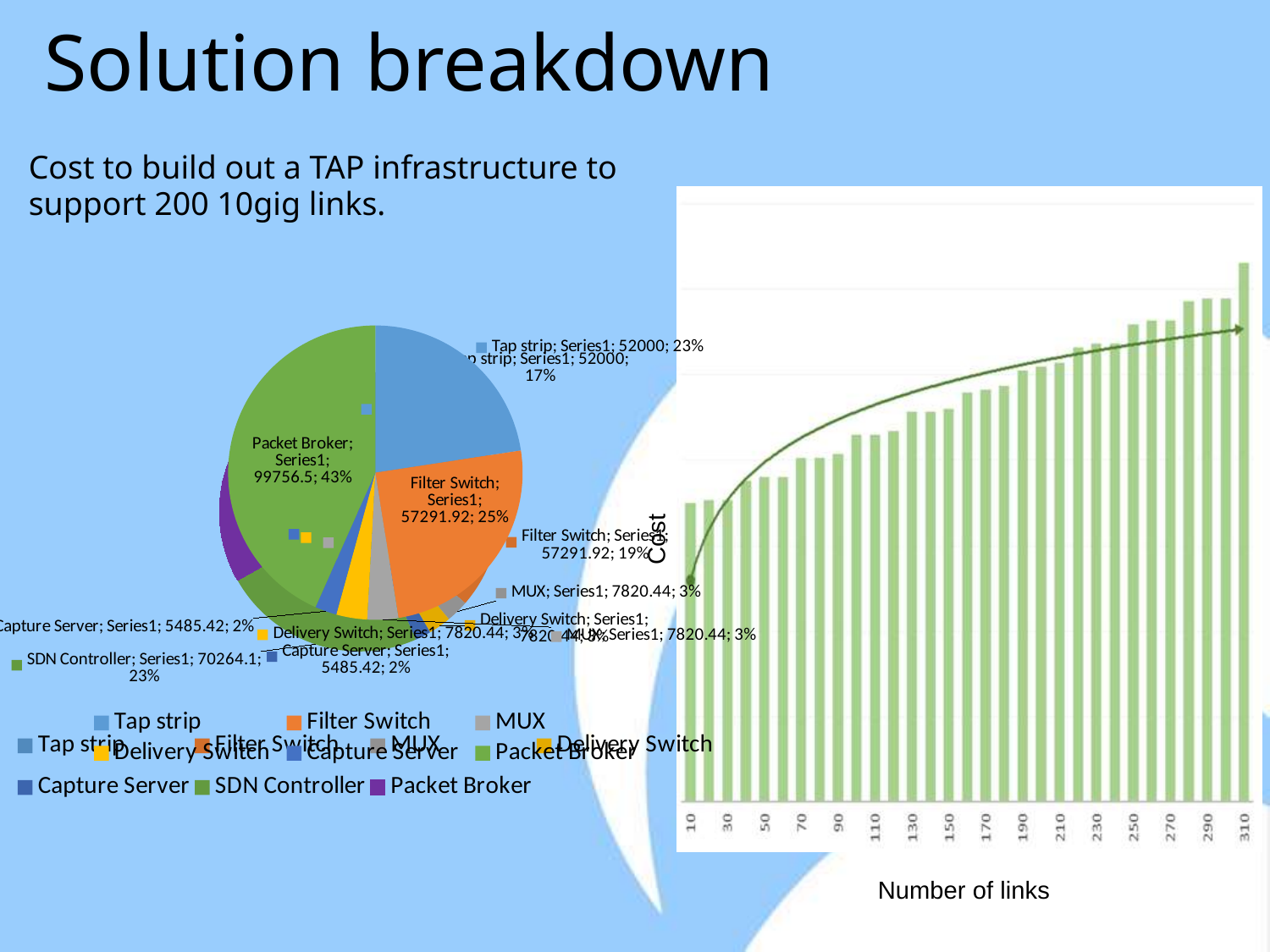
In the pie chart, what is the difference between the Filter Switch value (57291.92) and the Tap strip value (52000)? 5291.92 In the pie chart, what value is shown for Packet Broker? 99756.5 In the pie chart, what value is shown for Capture Server? 5485.42 In the bar chart on the right, do the bars generally rise or fall as the number of links increases? rise In the pie chart, which has the larger value: Packet Broker or Tap strip? Packet Broker In the bar chart on the right, which bar is taller: the one at 310 links or the one at 10 links? 310 In the bar chart on the right, what is the title of the y axis? Cost What type of chart is shown on the right side of the slide? bar chart In the bar chart on the right, which number of links has the highest bar? 310 In the pie chart, what percentage share is labelled for Packet Broker? 43% In the pie chart, what value is shown for SDN Controller? 70264.1 In the bar chart on the right, what is the title of the x axis? Number of links